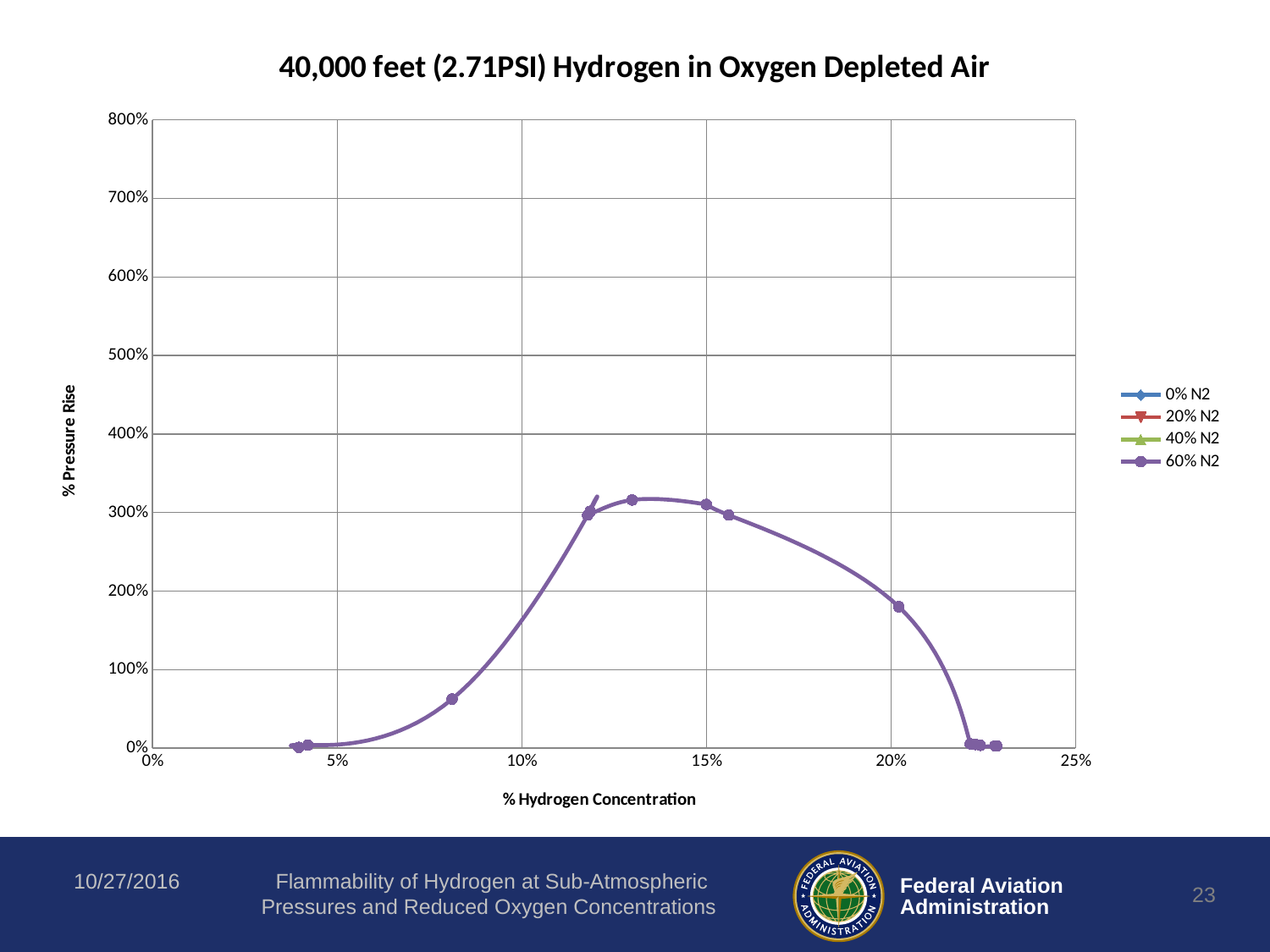
How many series does the legend list? 4 What kind of chart is shown on the slide? line chart Does the 60% N2 curve rise or fall between 15% and 22% hydrogen concentration? fall Does the 60% N2 curve rise or fall between 5% and 13% hydrogen concentration? rise What is the label of the x axis? % Hydrogen Concentration What is the title of the chart? 40,000 feet (2.71PSI) Hydrogen in Oxygen Depleted Air Is the 60% N2 value at about 20% hydrogen concentration greater or less than 200%? less Which series in the legend is drawn in purple? 60% N2 Is the 60% N2 value at about 8% hydrogen concentration greater or less than 100%? less Is the 60% N2 value at about 13% hydrogen concentration greater or less than 200%? greater